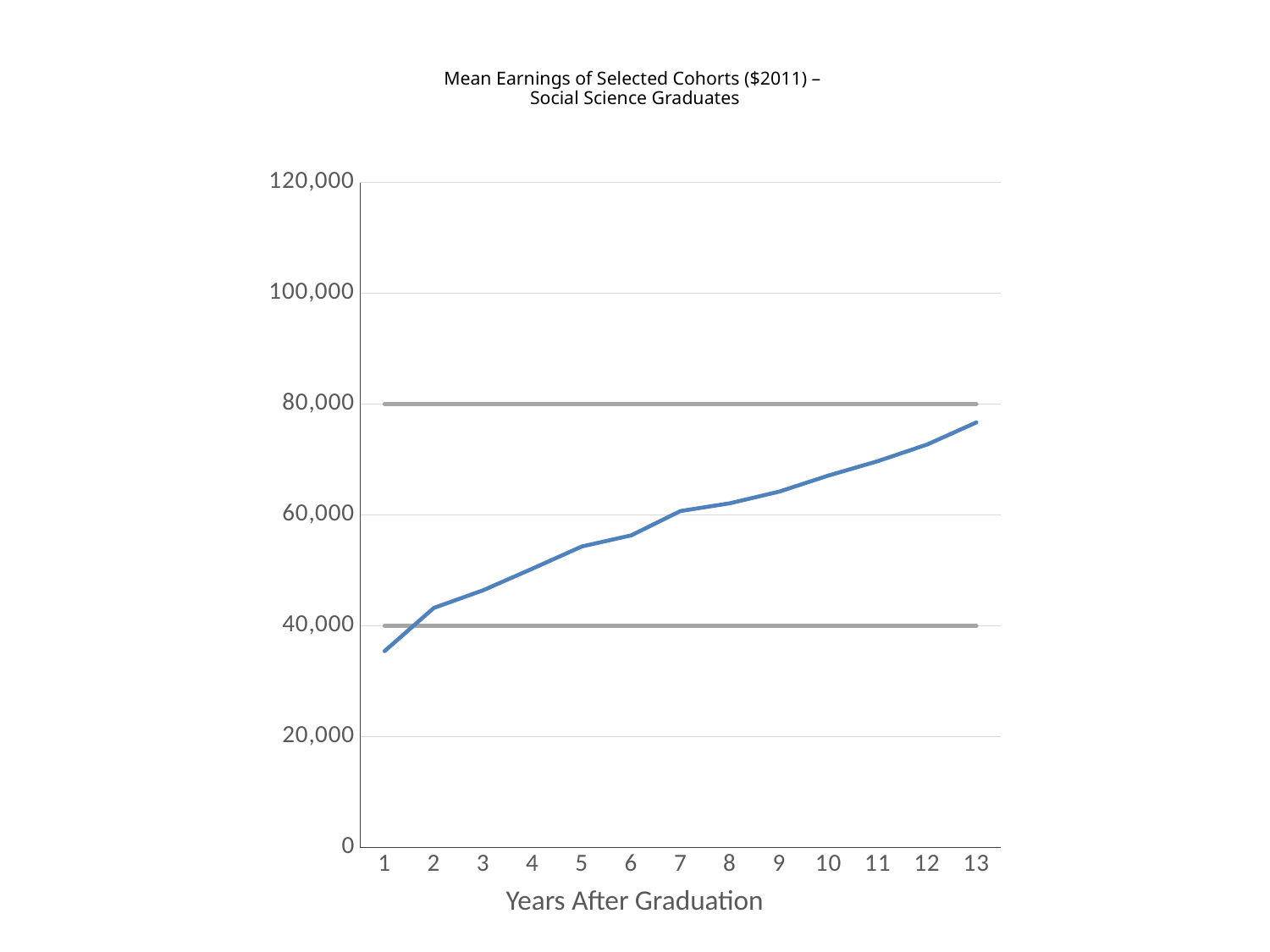
What is the title of the chart? Mean Earnings of Selected Cohorts ($2011) – Social Science Graduates What kind of chart is shown on the slide? line chart Is the value for year 1 greater or less than 40,000? less What is the label of the x axis? Years After Graduation Which has higher mean earnings, year 3 or year 9? year 9 Do the mean earnings rise or fall as years after graduation increase? rise At which year after graduation are mean earnings highest? 13 How many years after graduation are plotted along the x axis? 13 At which year after graduation are mean earnings lowest? 1 Is the value for year 13 greater or less than 80,000? less At what value is the upper gray horizontal line drawn? 80,000